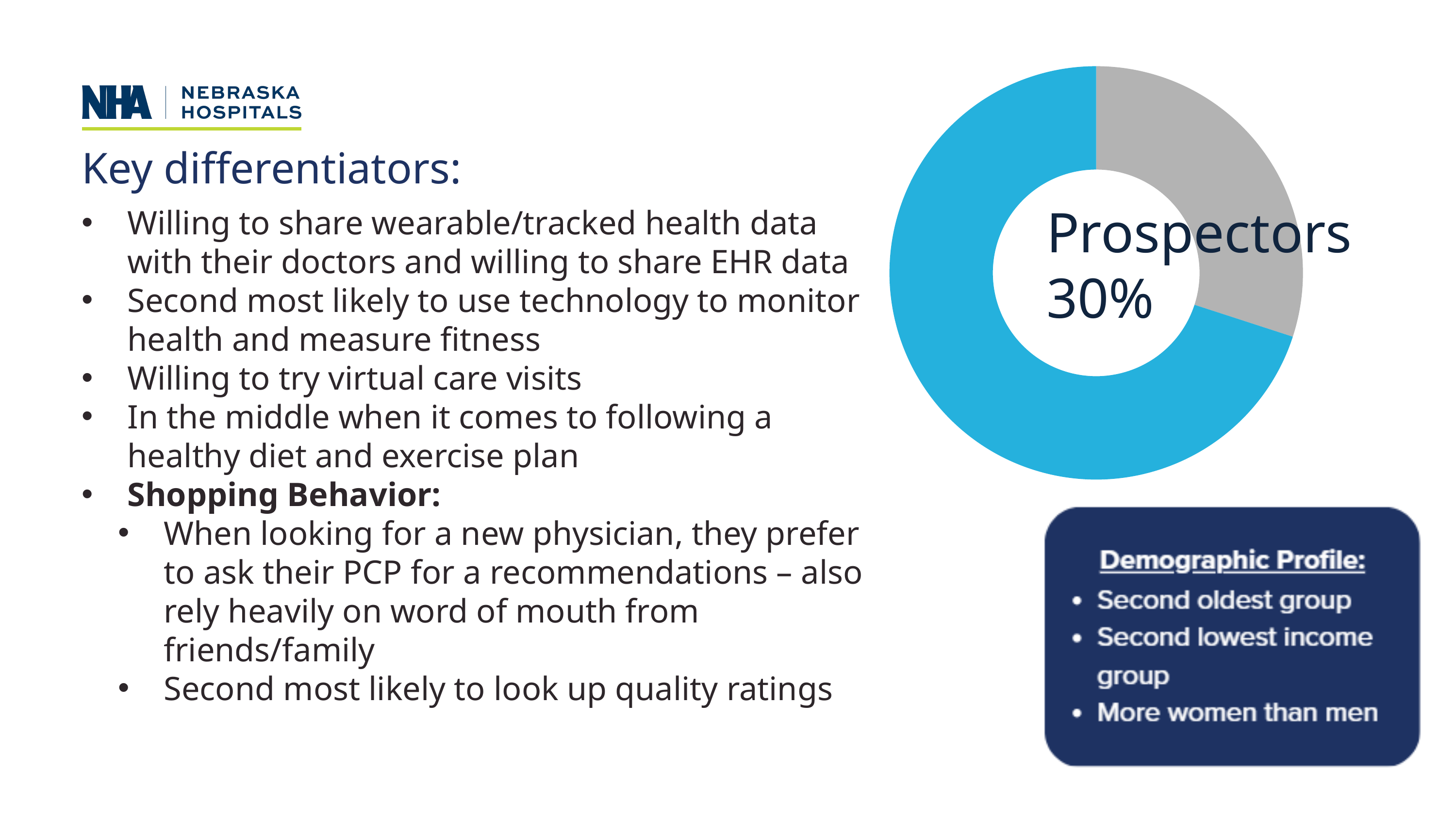
Is the Prospectors share shown in the donut chart greater or less than 50%? less What segment name is printed in the center of the donut chart? Prospectors What percentage is printed in the center of the donut chart? 30% Which slice of the donut chart is larger, the blue slice or the gray slice? The blue slice What share of the donut chart is labeled for Prospectors? 30% Which slice of the donut chart is the smallest? The gray slice (Prospectors, 30%) How many slices does the donut chart have? 2 What kind of chart is shown on the slide? Donut (pie) chart What colour is the slice representing the Prospectors' 30% share? Gray